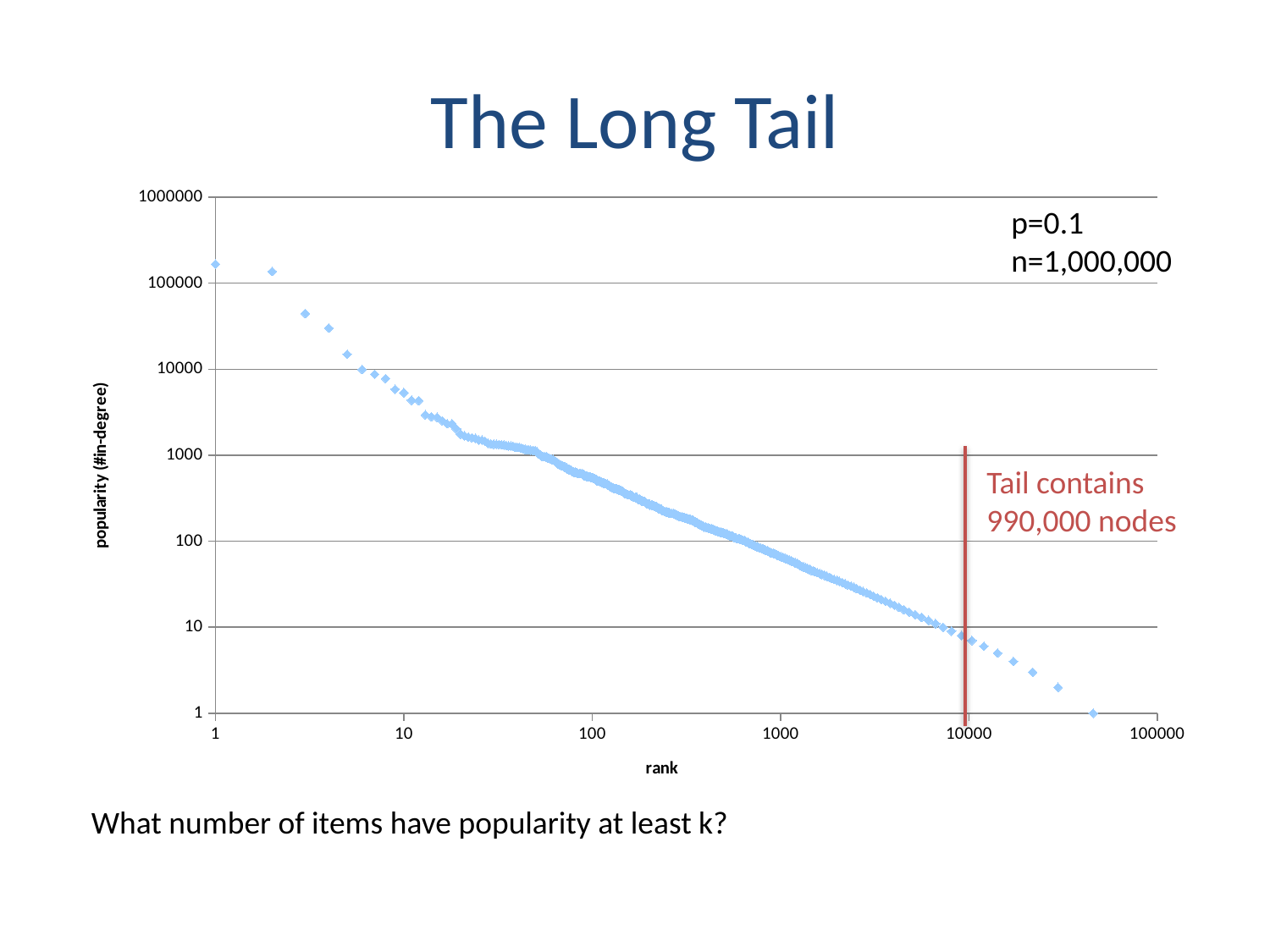
Is the popularity value at rank 10 greater or less than 1000? greater Which has the larger popularity, rank 1 or rank 10? rank 1 Is the popularity value at rank 1 greater or less than 100000? greater Does popularity rise or fall as rank increases along the x axis? fall Which has the larger popularity, rank 100 or rank 1000? rank 100 According to the annotation next to the red vertical line, how many nodes does the tail contain? 990,000 nodes Which rank has the highest popularity? 1 Is the popularity value at rank 1000 greater or less than 100? less What kind of chart is shown on the slide? scatter plot What is the label of the y axis? popularity (#in-degree)